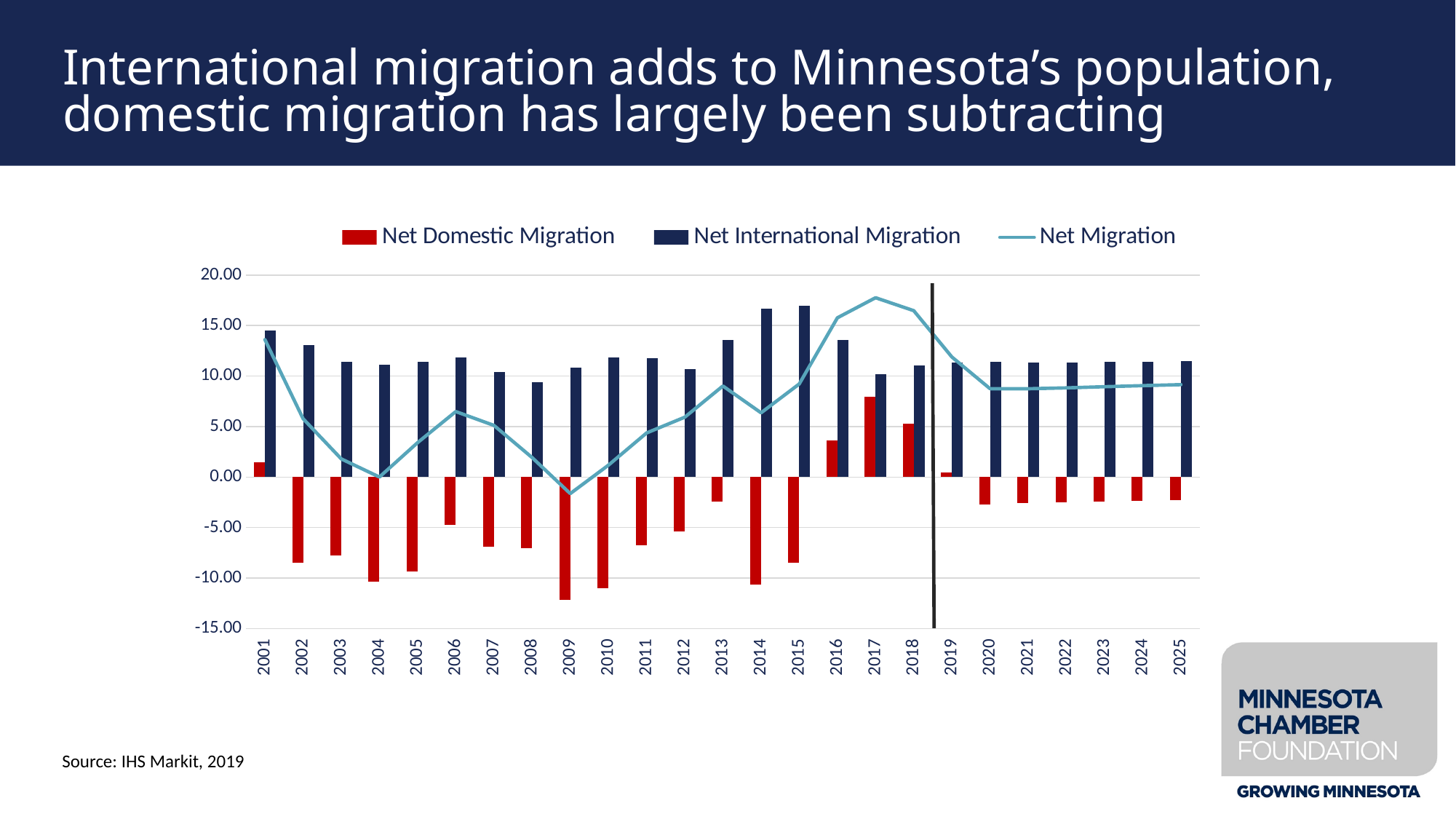
How many series does the legend list? 3 Is the value for Net Domestic Migration in 2009 greater or less than -10.00? less Is the value for Net International Migration in 2008 greater or less than 10.00? less In which year is Net Domestic Migration lowest? 2009 What kind of chart is shown on the slide? A combined bar and line chart In which year does the Net Migration line reach its highest point? 2017 In which year is Net Domestic Migration highest? 2017 Does the Net Migration line rise or fall from 2017 to 2019? fall What colour are the Net Domestic Migration bars? Red Is the value for Net International Migration in 2001 greater or less than 10.00? greater How many years are shown on the x axis? 25 Which year has the larger Net International Migration, 2014 or 2008? 2014